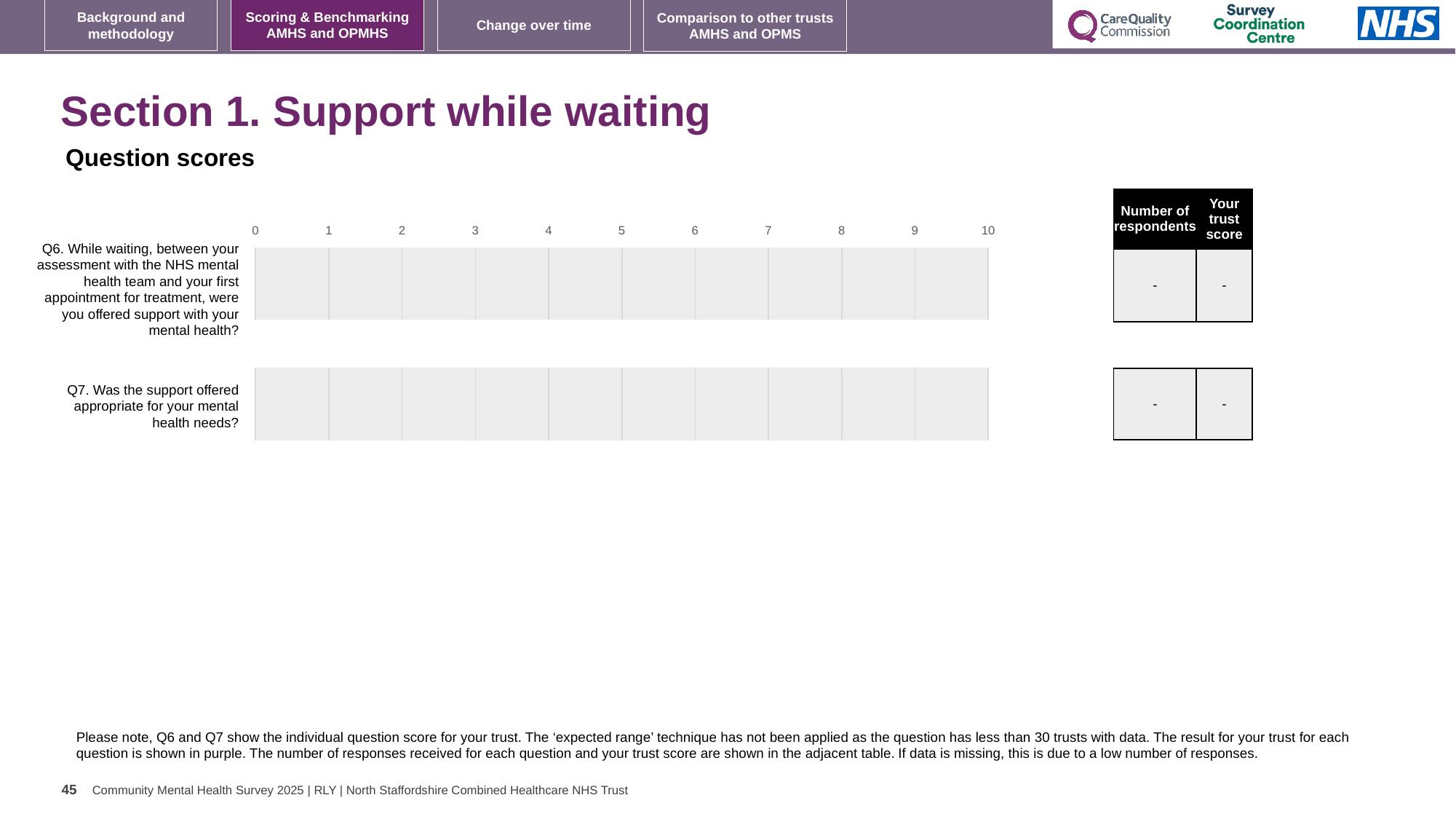
What value is shown in the 'Your trust score' column for Q6? - How many questions (categories) are listed on the chart's vertical axis? 2 What value is shown in the 'Number of respondents' column for Q6? - What is the lowest value shown on the chart's horizontal axis? 0 What is the highest value shown on the chart's horizontal axis? 10 What is the label of the first question listed on the chart? Q6. While waiting, between your assessment with the NHS mental health team and your first appointment for treatment, were you offered support with your mental health? What value is shown in the 'Your trust score' column for Q7? - Are any bars plotted for Q6 or Q7 on the chart? No What value is shown in the 'Number of respondents' column for Q7? - What is the label of the second question listed on the chart? Q7. Was the support offered appropriate for your mental health needs?